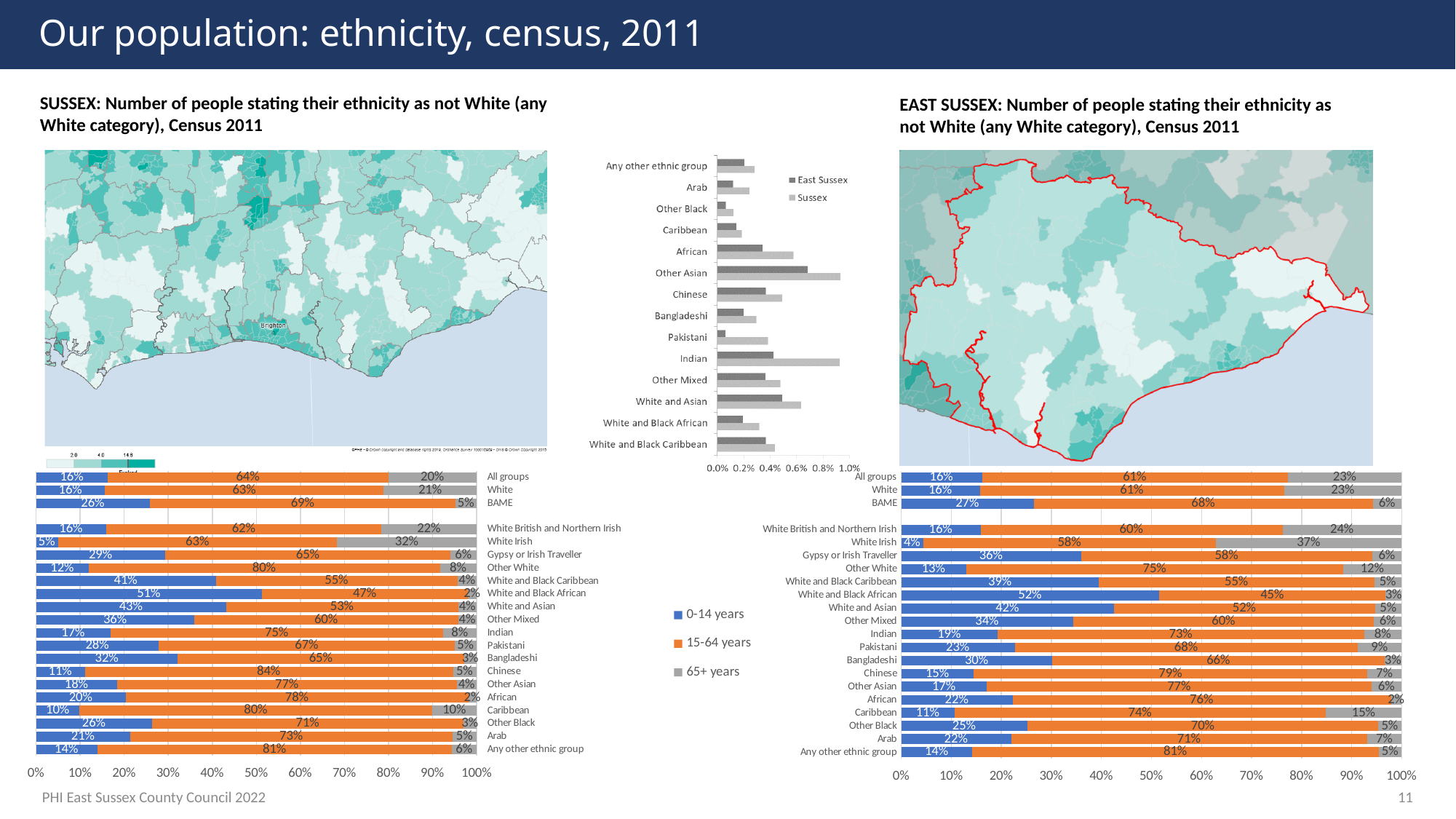
In the middle bar chart comparing East Sussex and Sussex, is the Sussex value for Other Asian greater or less than 0.8%? greater In the middle bar chart comparing East Sussex and Sussex, is the East Sussex value for Pakistani greater or less than 0.2%? less In the middle bar chart comparing East Sussex and Sussex, how many series does the legend list? 2 In the middle bar chart comparing East Sussex and Sussex, which ethnic group has the lowest East Sussex value? Pakistani In the bottom-left stacked bar chart for Sussex, which group has the highest share aged 0-14 years? White and Black African In the bottom-left stacked bar chart for Sussex, what percentage of the Chinese group is aged 15-64 years? 84% In the bottom-left stacked bar chart for Sussex, what percentage of the White Irish group is aged 65+ years? 32% In the bottom-right stacked bar chart for East Sussex, what is the difference between the 0-14 years share for BAME and for White? 11% In the bottom-right stacked bar chart for East Sussex, what percentage of the Caribbean group is aged 65+ years? 15% What kind of chart is the bottom-right chart for East Sussex? Stacked bar chart In the middle bar chart comparing East Sussex and Sussex, how many ethnic group categories are plotted? 14 In the middle bar chart comparing East Sussex and Sussex, which ethnic group has the highest East Sussex value? Other Asian